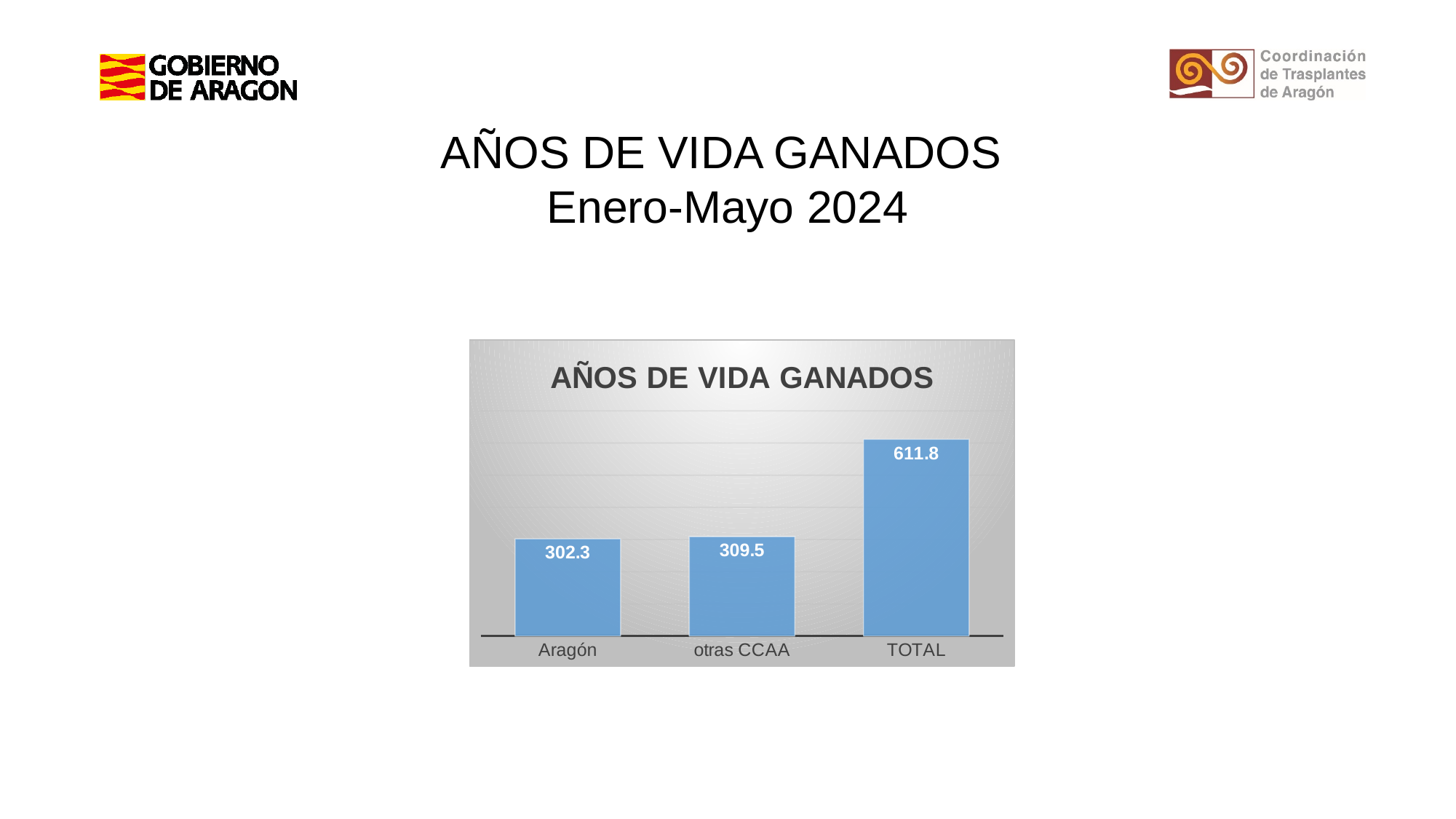
Which category has the highest value? TOTAL What is the value for otras CCAA? 309.5 What is the difference between the otras CCAA value and the Aragón value? 7.2 What is the difference between the TOTAL value and the Aragón value? 309.5 What is the title of the chart? AÑOS DE VIDA GANADOS Which is larger, the value for Aragón or the value for otras CCAA? otras CCAA What is the value for Aragón? 302.3 What is the value for TOTAL? 611.8 What kind of chart is shown on the slide? bar chart Which category has the lowest value? Aragón How many categories are shown on the x axis? 3 What colour are the bars in the chart? blue